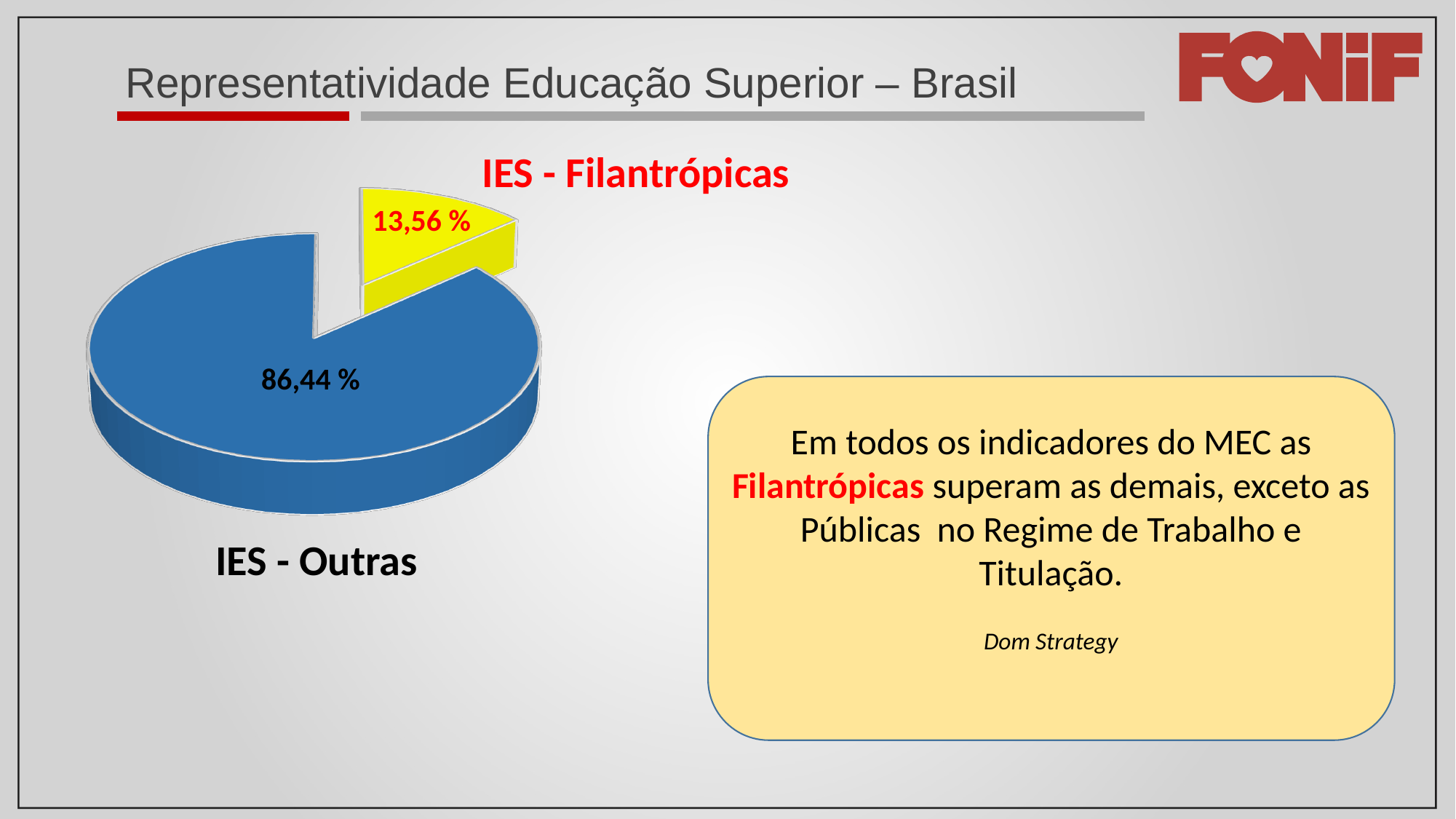
What colour is the IES - Outras slice? Blue What kind of chart is shown on the slide? Pie chart What share of the pie does IES - Filantrópicas represent? 13,56 % What is the difference between the IES - Outras and IES - Filantrópicas values? 72,88 % Which is larger, IES - Outras or IES - Filantrópicas? IES - Outras How many slices does the pie chart have? 2 Which slice of the pie is the largest? IES - Outras What is the value shown for IES - Outras? 86,44 % What colour is the IES - Filantrópicas slice? Yellow What is the value shown for IES - Filantrópicas? 13,56 % Which slice of the pie is the smallest? IES - Filantrópicas